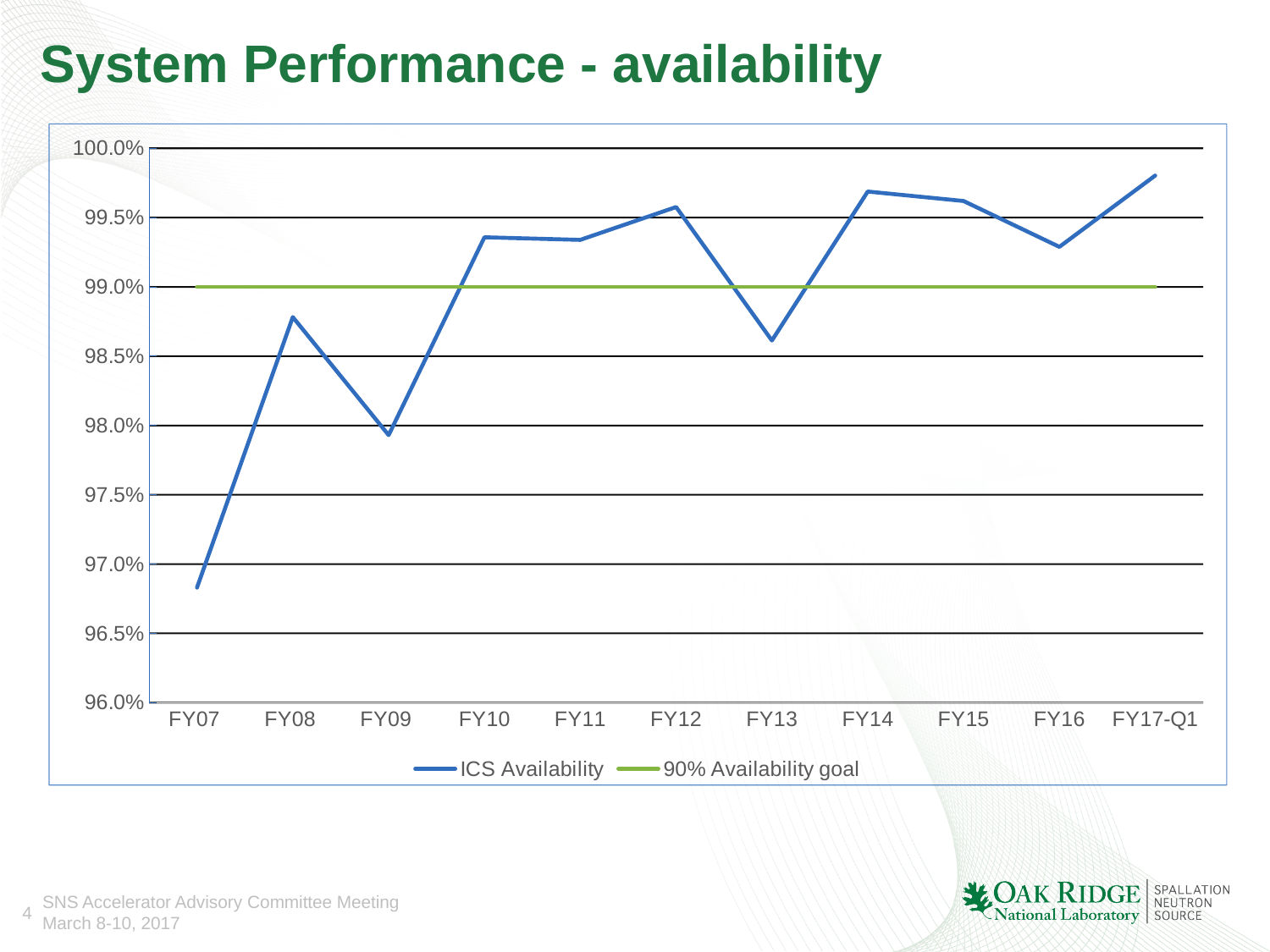
Which fiscal year has the lowest ICS Availability? FY07 Is the ICS Availability for FY07 greater or less than 97.0%? less Which fiscal year has the highest ICS Availability? FY17-Q1 Which has the higher ICS Availability, FY08 or FY09? FY08 What kind of chart is shown on the slide? line chart Does ICS Availability overall rise or fall from FY07 to FY17-Q1? rise Is the ICS Availability for FY09 greater or less than 98.0%? less Is the ICS Availability for FY13 greater or less than 99.0%? less How many fiscal-year categories are shown on the x axis? 11 At what value on the y axis is the 90% Availability goal line plotted? 99.0% How many series does the legend list? 2